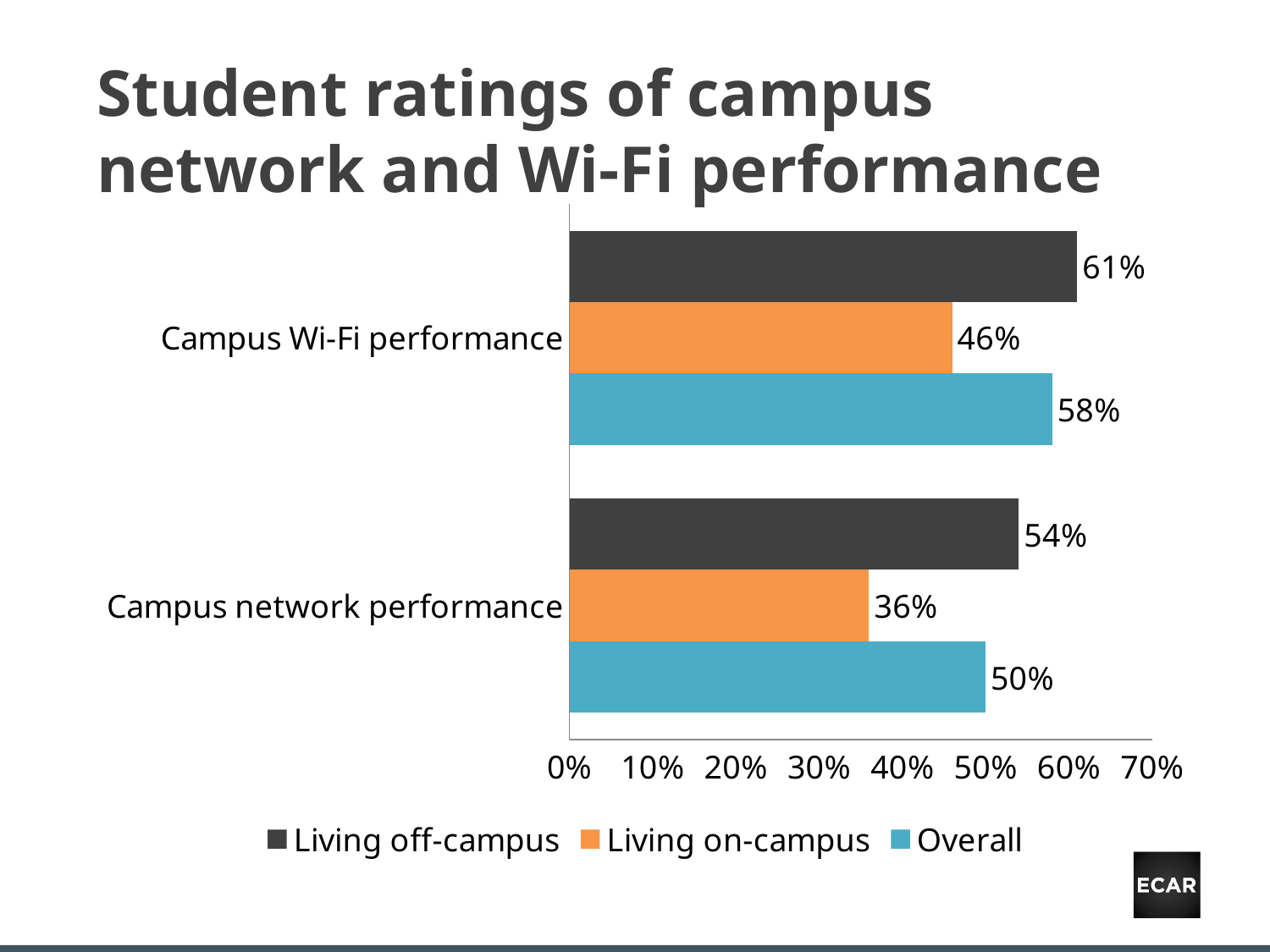
Which is larger: the Living on-campus value for Campus Wi-Fi performance or for Campus network performance? Campus Wi-Fi performance How many series does the legend list? 3 What is the value for Living off-campus for Campus Wi-Fi performance? 61% What is the Overall value for Campus network performance? 50% What is the difference between the Overall values for Campus Wi-Fi performance and Campus network performance? 8% What is the value for Living on-campus for Campus network performance? 36% What is the Overall value for Campus Wi-Fi performance? 58% Which series has the highest value for Campus network performance? Living off-campus How many categories are shown on the chart? 2 What is the difference between the Living off-campus and Living on-campus values for Campus Wi-Fi performance? 15% Which series has the lowest value for Campus Wi-Fi performance? Living on-campus What kind of chart is shown on the slide? Bar chart